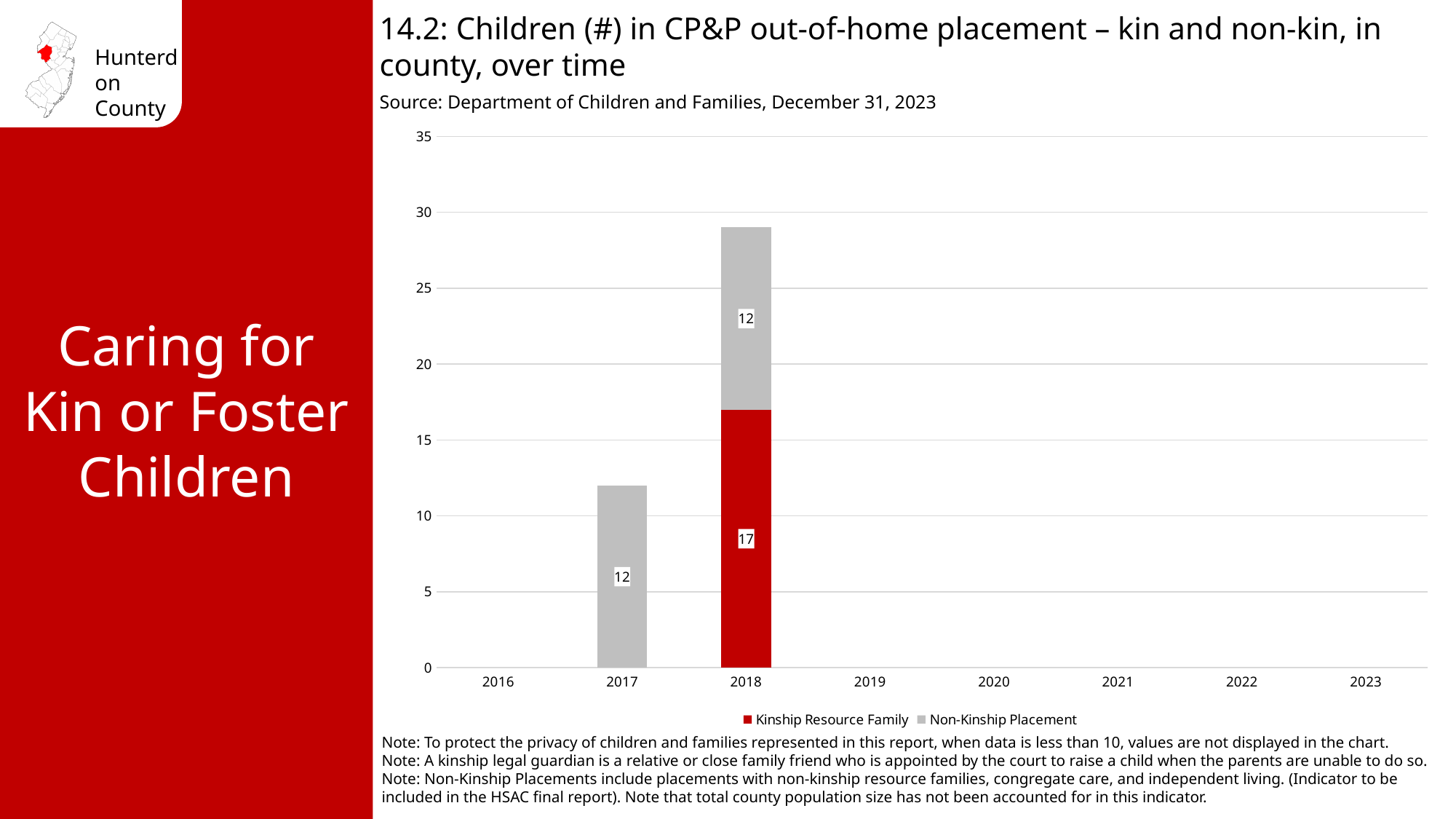
What is the value for Non-Kinship Placement in 2017? 12 What type of chart is shown on the slide? stacked bar chart What is the total of the stacked bar for 2018? 29 How many years are shown on the x axis? 8 What is the difference between the Kinship Resource Family value and the Non-Kinship Placement value in 2018? 5 What is the value for Kinship Resource Family in 2018? 17 Which year has the highest total bar? 2018 In 2018, which is larger: Kinship Resource Family or Non-Kinship Placement? Kinship Resource Family Which series is shown in red? Kinship Resource Family Is the total bar for 2018 greater or less than 25? greater How many series does the legend list? 2 What is the value for Non-Kinship Placement in 2018? 12